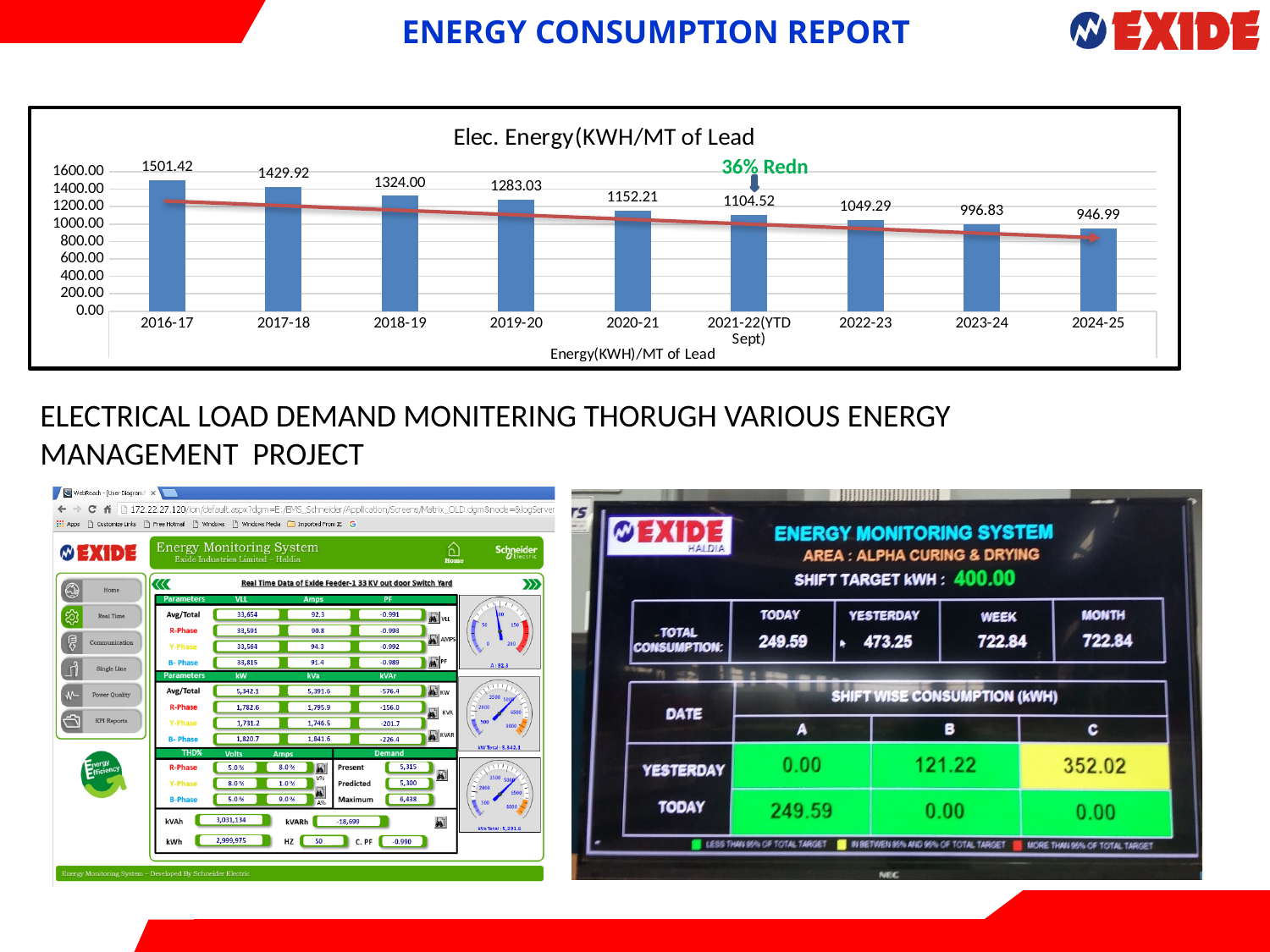
What kind of chart is the Elec. Energy chart? bar chart How many years are shown on the x axis of the Elec. Energy chart? 9 Which year has the lowest value in the Elec. Energy chart? 2024-25 What is the value for 2016-17 in the Elec. Energy chart? 1501.42 What is the difference between the values for 2016-17 and 2024-25 in the Elec. Energy chart? 554.43 What percentage reduction is annotated on the Elec. Energy chart? 36% Redn Which is larger in the Elec. Energy chart, the value for 2018-19 or the value for 2019-20? 2018-19 Do the values in the Elec. Energy chart rise or fall from 2016-17 to 2024-25? fall What is the value for 2020-21 in the Elec. Energy chart? 1152.21 Which year has the highest value in the Elec. Energy chart? 2016-17 Is the value for 2023-24 in the Elec. Energy chart greater or less than 1000.00? less What is the value for 2024-25 in the Elec. Energy chart? 946.99